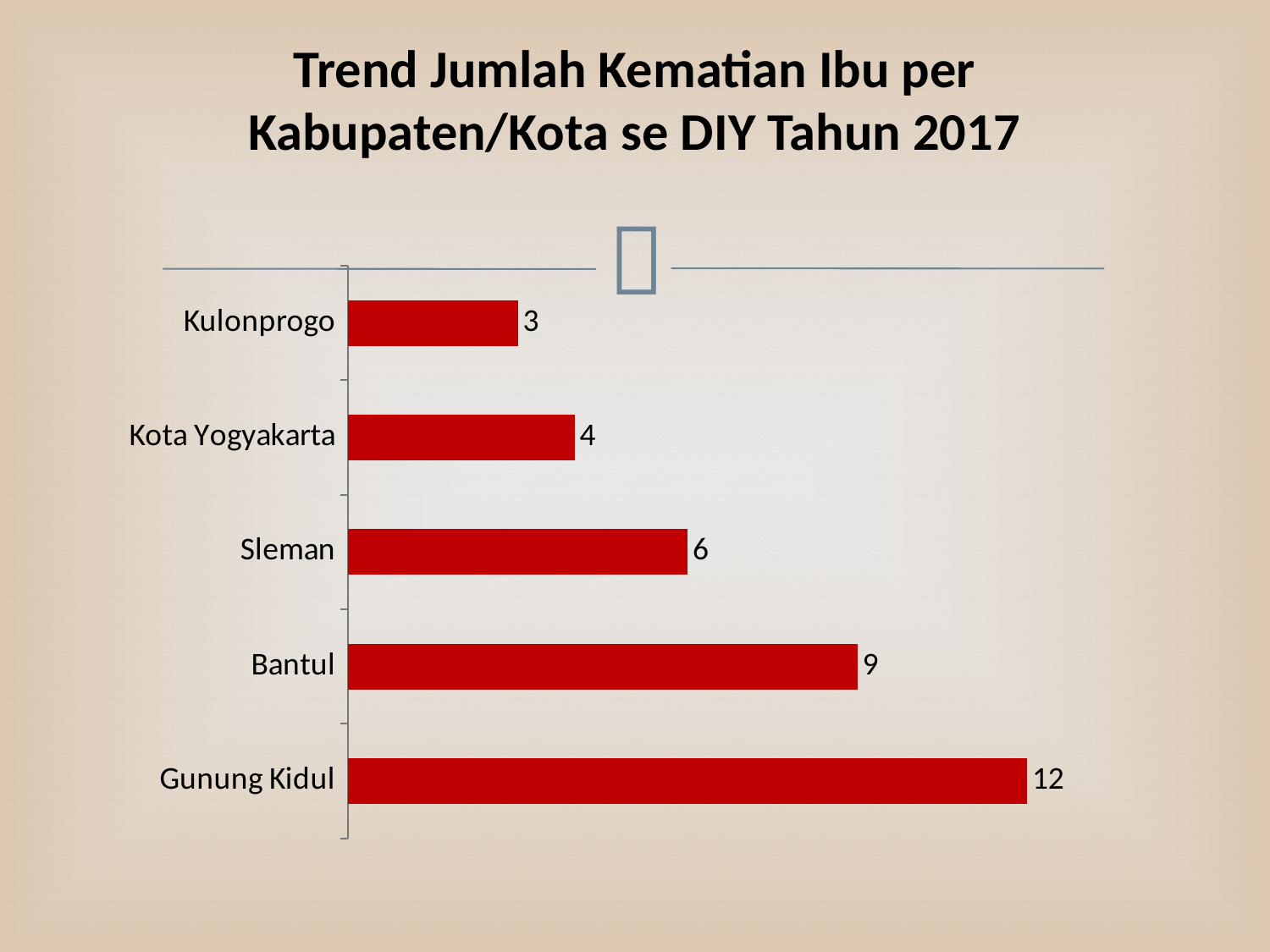
Which category has the highest value? Gunung Kidul What kind of chart is shown on the slide? Bar chart What is the title of the slide? Trend Jumlah Kematian Ibu per Kabupaten/Kota se DIY Tahun 2017 Which is larger, the value for Bantul or the value for Sleman? Bantul What is the value for Gunung Kidul? 12 Which category has the lowest value? Kulonprogo What is the value for Bantul? 9 What is the value for Sleman? 6 What is the difference between the values for Sleman and Kulonprogo? 3 What is the value for Kota Yogyakarta? 4 How many categories are shown in the chart? 5 What is the difference between the values for Gunung Kidul and Bantul? 3